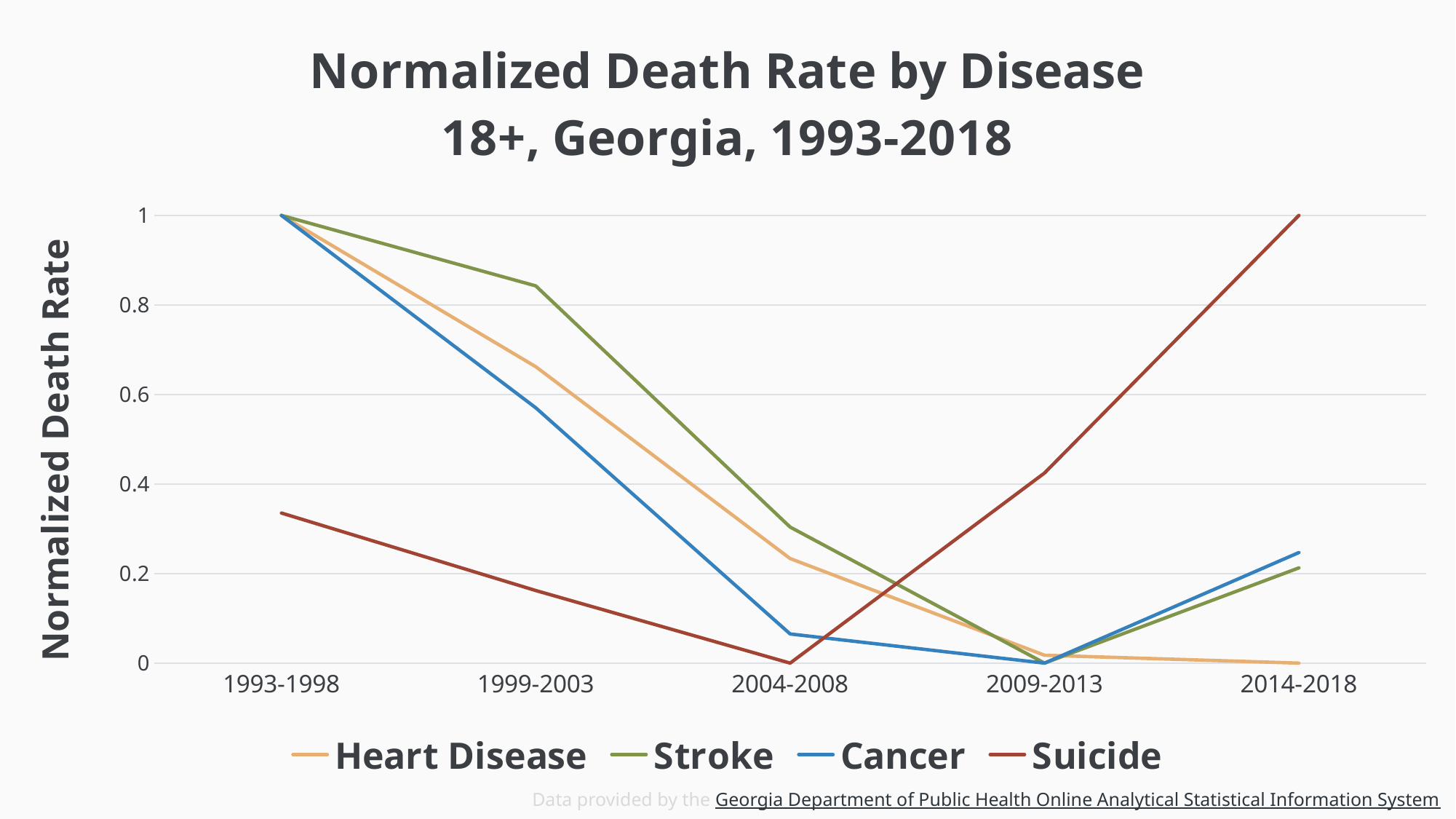
In which period is the Suicide normalized death rate highest? 2014-2018 In 1999-2003, which has the higher normalized death rate, Stroke or Cancer? Stroke Is the value for Stroke in 1999-2003 greater or less than 0.8? greater What is the normalized death rate for Suicide in 2014-2018? 1 In which period is the Suicide normalized death rate lowest? 2004-2008 Is the value for Suicide in 1993-1998 greater or less than 0.4? less What is the normalized death rate for Stroke in 1993-1998? 1 How many time periods are shown on the x axis? 5 How many series does the legend list? 4 What kind of chart is shown on the slide? line chart Does the Suicide line rise or fall from 2004-2008 to 2014-2018? rise What is the normalized death rate for Suicide in 2004-2008? 0